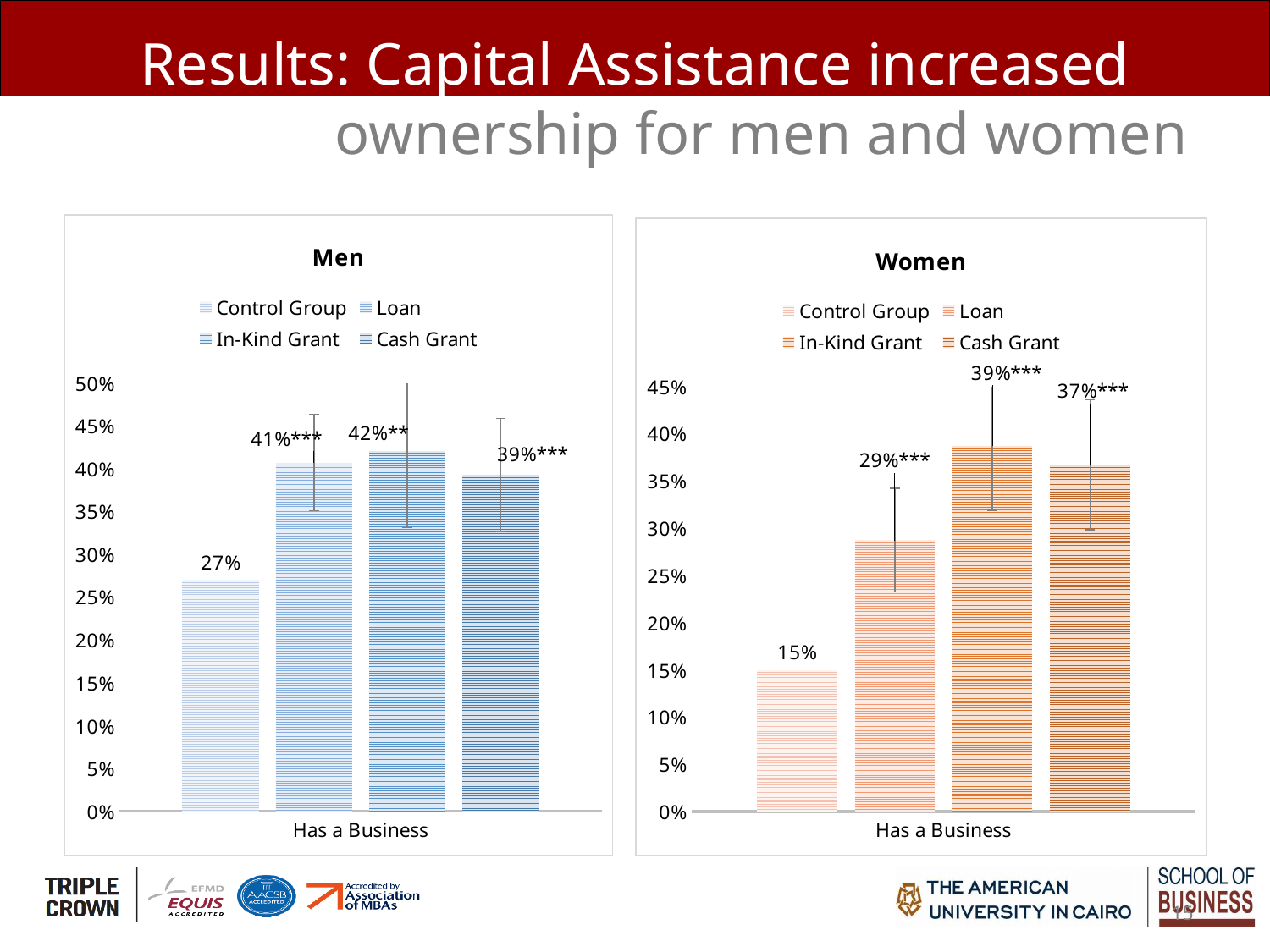
In the Women chart, which is larger: the Loan value or the Cash Grant value? Cash Grant In the Men chart, what is the value for the Control Group? 27% What type of chart is the Women chart? Bar chart How many series does the legend of the Men chart list? 4 In the Women chart, what is the difference in percentage points between the In-Kind Grant (39%) and the Control Group (15%)? 24 percentage points In the Men chart, which group has the lowest value? Control Group In the Women chart, what is the data label shown for the Cash Grant bar? 37%*** In the Women chart, what is the value for the Control Group? 15% In the Men chart, what is the difference in percentage points between the Loan group (41%) and the Control Group (27%)? 14 percentage points What is the x-axis category label shown under the bars in the Men chart? Has a Business In the Women chart, which group has the highest value? In-Kind Grant In the Men chart, what is the data label shown for the In-Kind Grant bar? 42%**